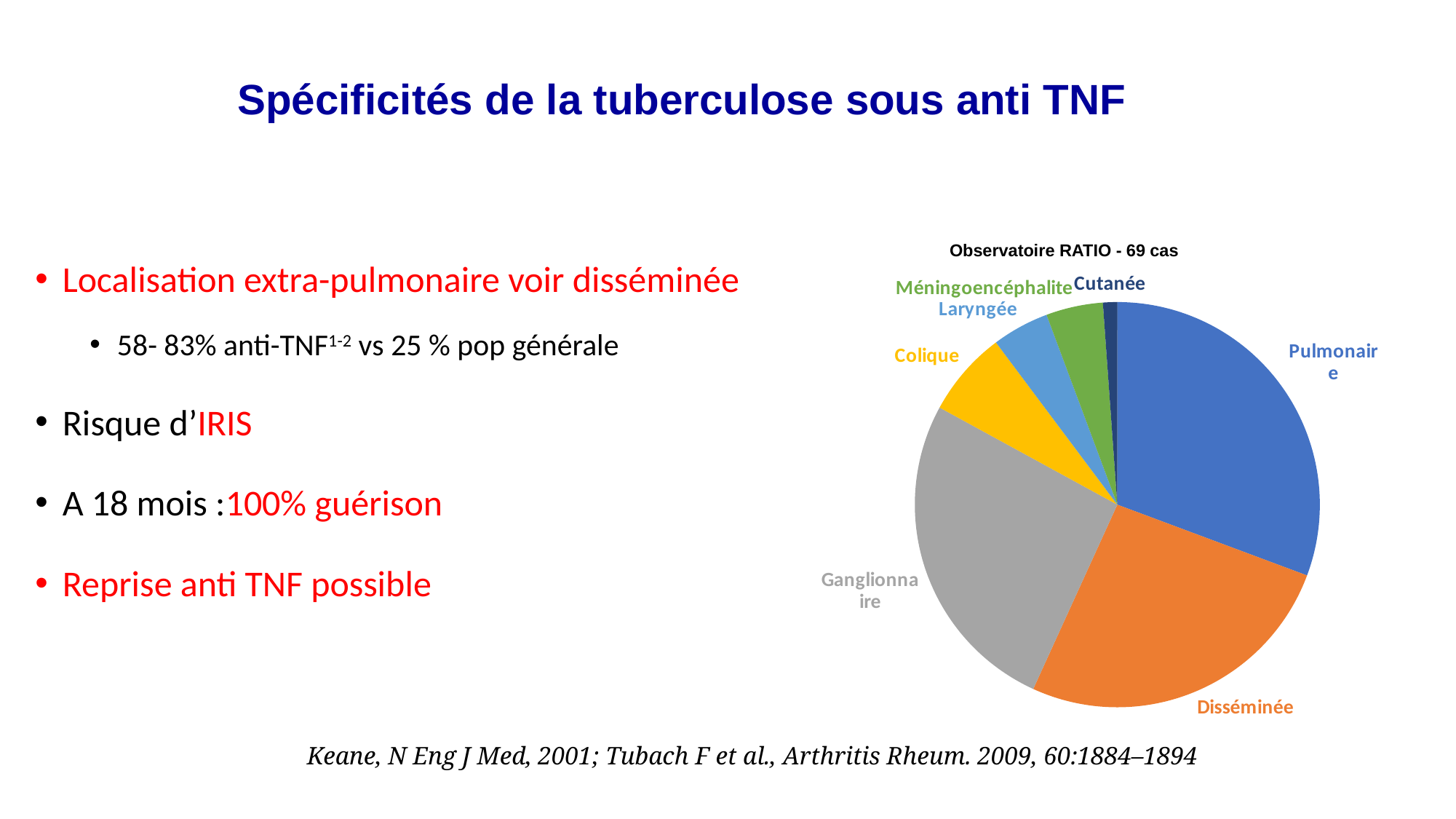
Which category has the smallest slice in the pie chart? Cutanée How many slices does the pie chart have? 7 What is the title of the pie chart? Observatoire RATIO - 69 cas What kind of chart is shown on the slide? pie chart Which slice is larger, Disséminée or Laryngée? Disséminée Which slice is larger, Colique or Cutanée? Colique What colour is the Disséminée slice in the pie chart? orange Which slice is larger, Pulmonaire or Ganglionnaire? Pulmonaire